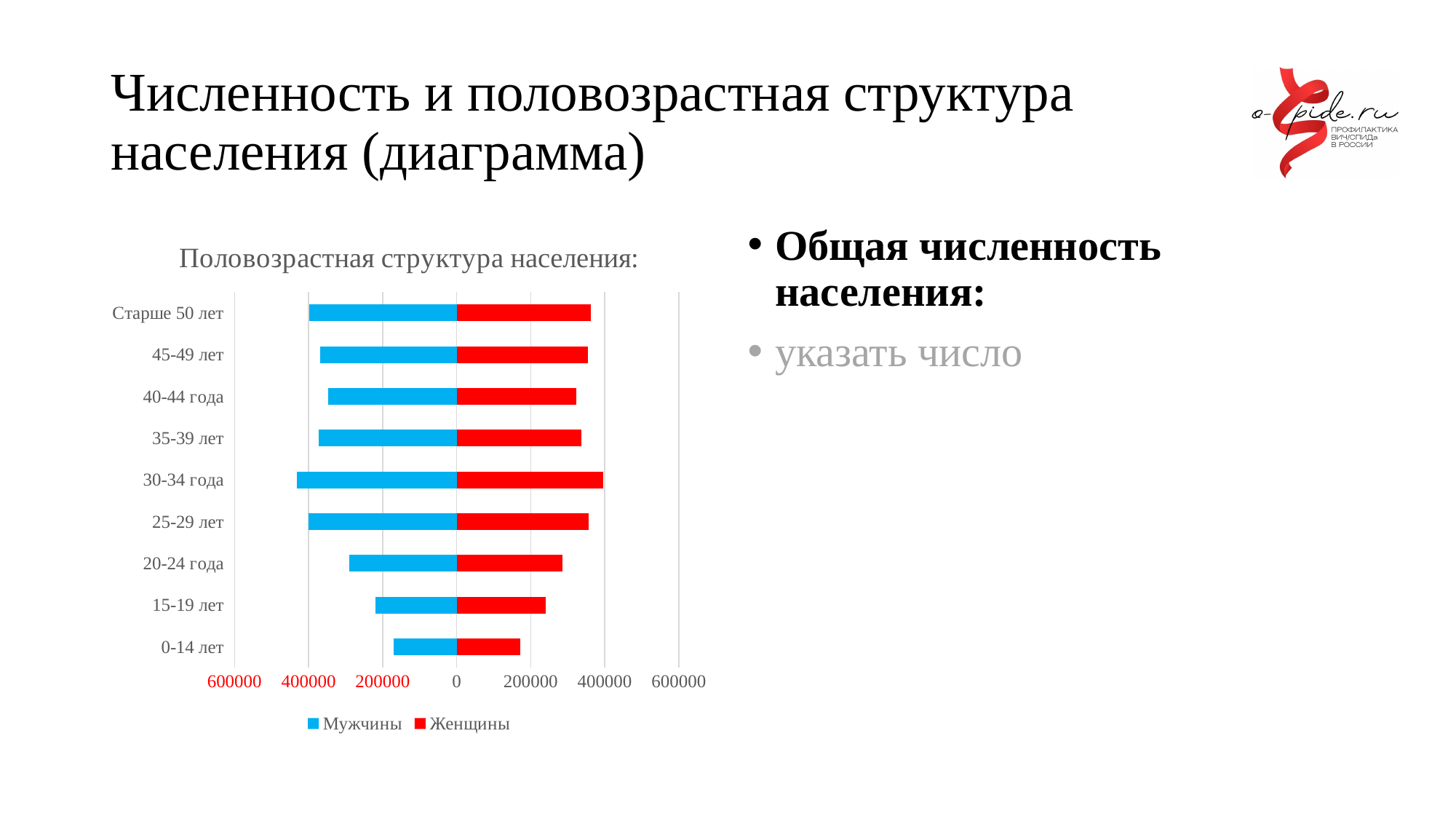
How many series does the chart legend list? 2 Which age group has the highest value for Женщины? 30-34 года Which is larger: the value for Женщины in the 30-34 года group or in the 20-24 года group? 30-34 года Which age group has the highest value for Мужчины? 30-34 года Which age group has the lowest value for Женщины? 0-14 лет Is the value for Мужчины in the 0-14 лет group greater or less than 200000? less What colour represents the Мужчины series in the chart? blue How many age groups are shown on the chart? 9 Which age group has the lowest value for Мужчины? 0-14 лет Is the value for Мужчины in the 20-24 года group greater or less than 200000? greater What kind of chart is shown on the slide? bar chart Is the value for Женщины in the 15-19 лет group greater or less than 200000? greater